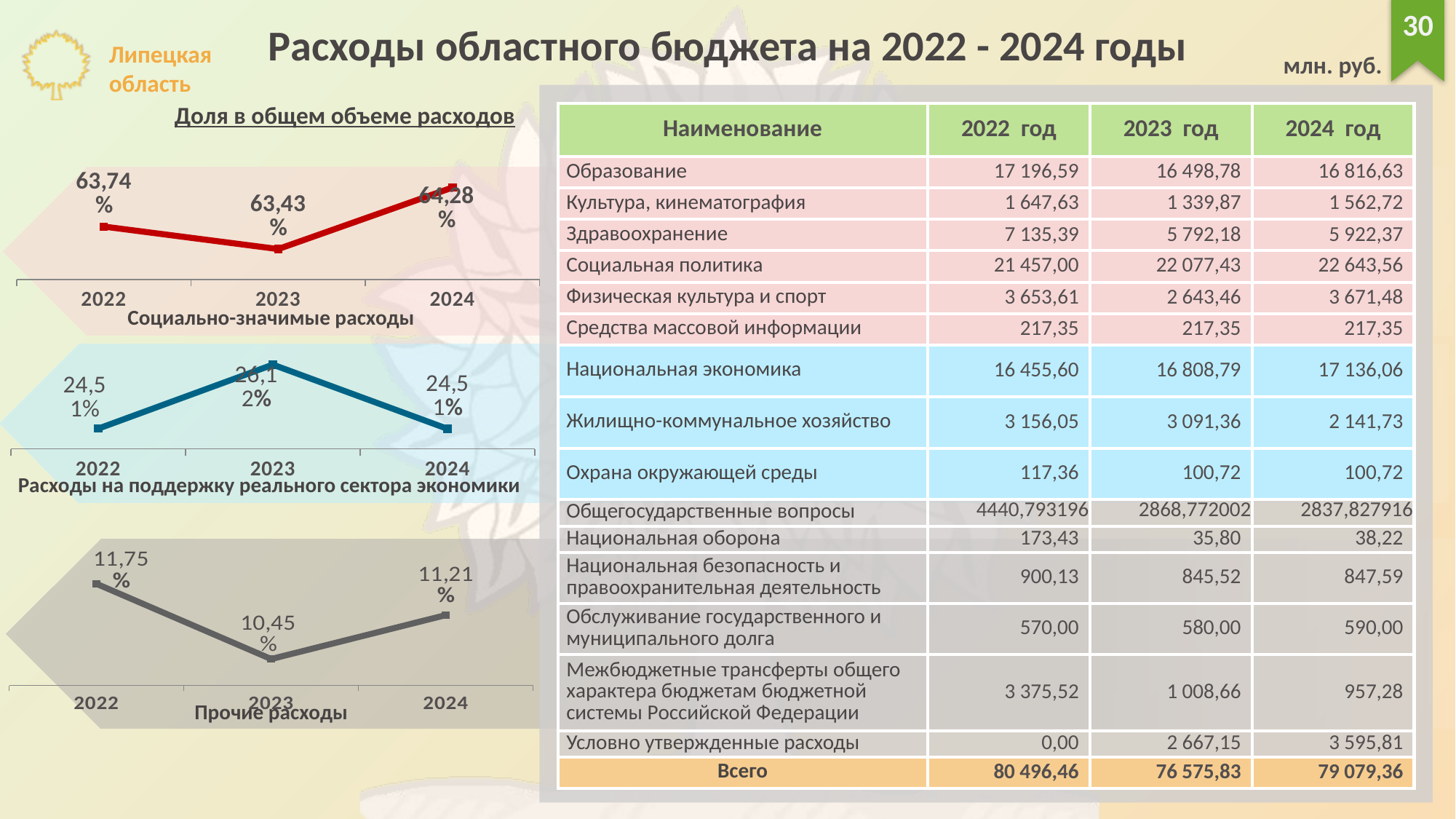
In the chart 'Прочие расходы', what is the value for 2023? 10,45% In the chart 'Социально-значимые расходы', what is the value for 2023? 63,43% In the chart 'Социально-значимые расходы', which year has the lowest value? 2023 In the chart 'Расходы на поддержку реального сектора экономики', what is the value for 2023? 26,12% In the chart 'Прочие расходы', what is the difference between the 2022 and 2023 values? 1,30% In the chart 'Социально-значимые расходы', which year has the highest value? 2024 How many data points does the chart 'Социально-значимые расходы' show? 3 In the chart 'Прочие расходы', which is larger, the value for 2022 or the value for 2024? 2022 In the chart 'Прочие расходы', what is the value for 2022? 11,75% In the chart 'Социально-значимые расходы', what is the value for 2022? 63,74% In the chart 'Расходы на поддержку реального сектора экономики', what is the value for 2024? 24,51% In the chart 'Расходы на поддержку реального сектора экономики', which year has the highest value? 2023